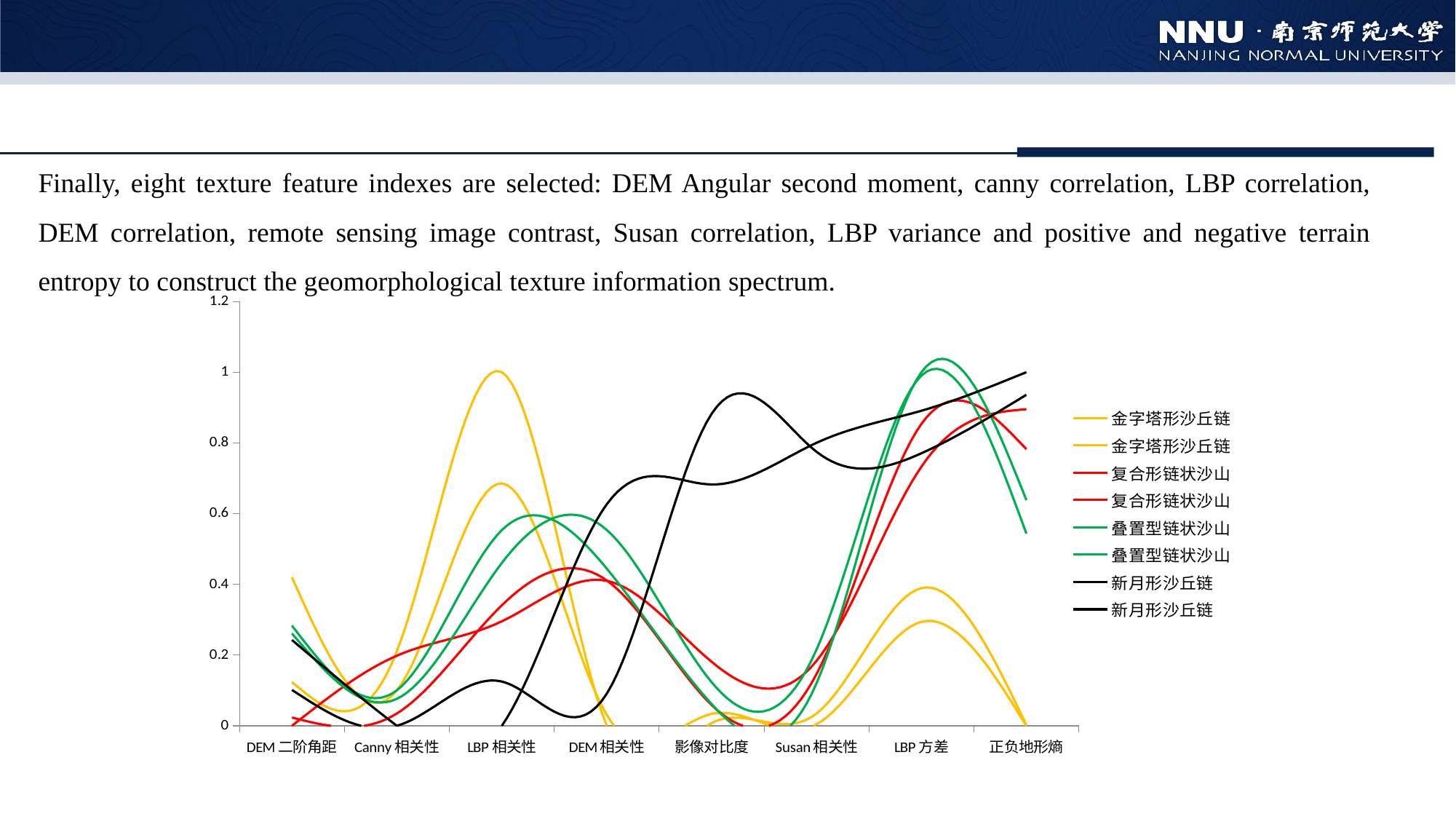
Are the values of the red lines at LBP 方差 greater or less than 0.6? greater What kind of chart is shown on the slide? line chart Are the values of the yellow lines at LBP 方差 greater or less than 0.6? less Are the values of the black lines at 影像对比度 greater or less than 0.6? greater How many categories are shown along the x axis of the chart? 8 What colour are the 新月形沙丘链 lines in the chart? black Do the yellow lines rise or fall from LBP 相关性 to 影像对比度? fall What is the label of the first category on the x axis? DEM 二阶角距 How many series does the chart's legend list? 8